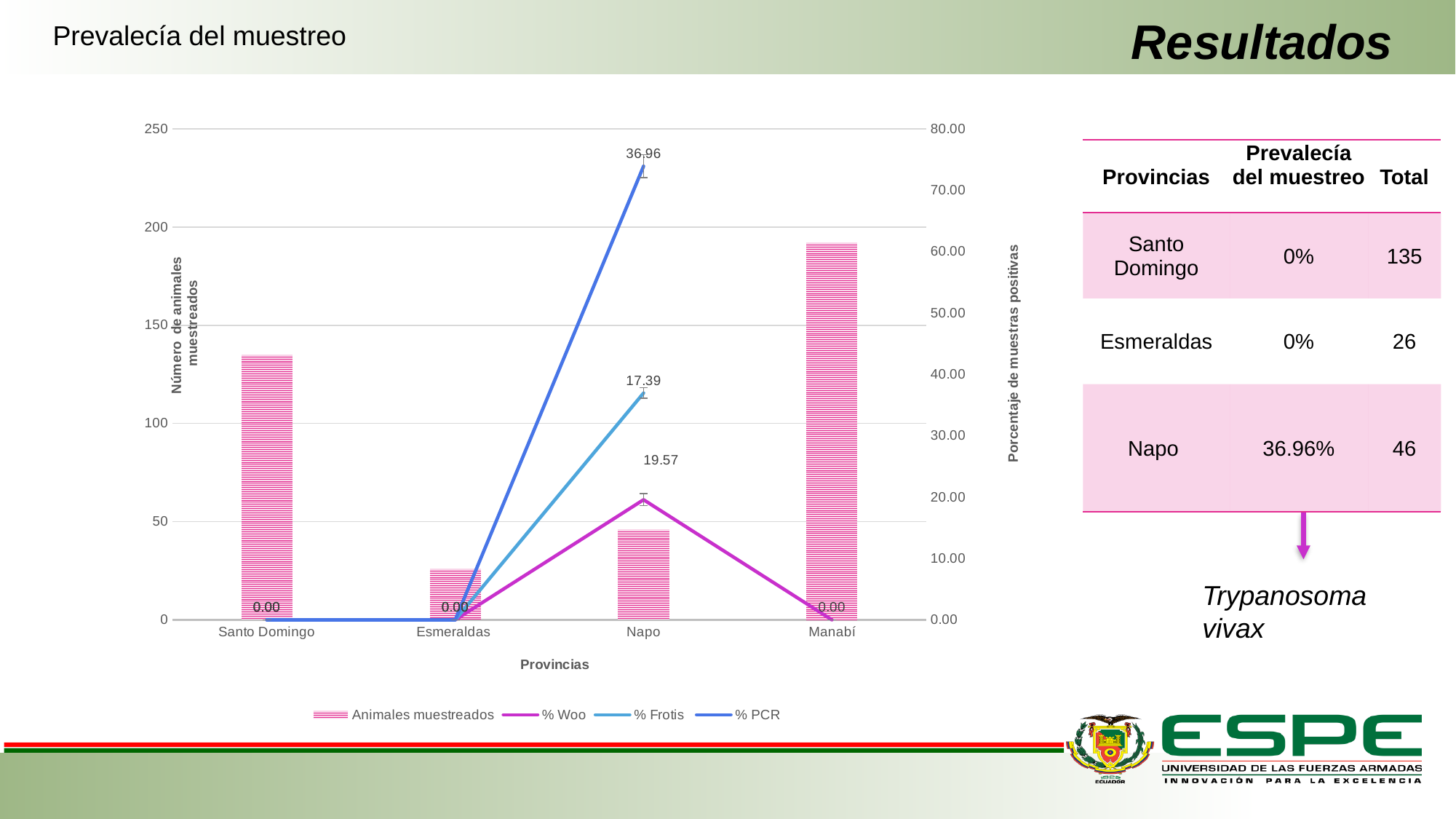
At Napo, which is larger: the % Woo value or the % Frotis value? % Woo What is the % PCR value for Napo? 36.96 What is the title of the x axis of the chart? Provincias What is the difference between the % PCR and % Frotis values for Napo? 19.57 How many provinces are shown on the x axis of the chart? 4 Is the Animales muestreados value for Santo Domingo greater or less than 100? greater What kind of chart is shown on the slide? A combination bar and line chart How many series does the chart legend list? 4 What is the % Frotis value for Napo? 17.39 What is the % Woo value for Napo? 19.57 Which province has the shortest Animales muestreados bar? Esmeraldas Which province has the tallest Animales muestreados bar? Manabí